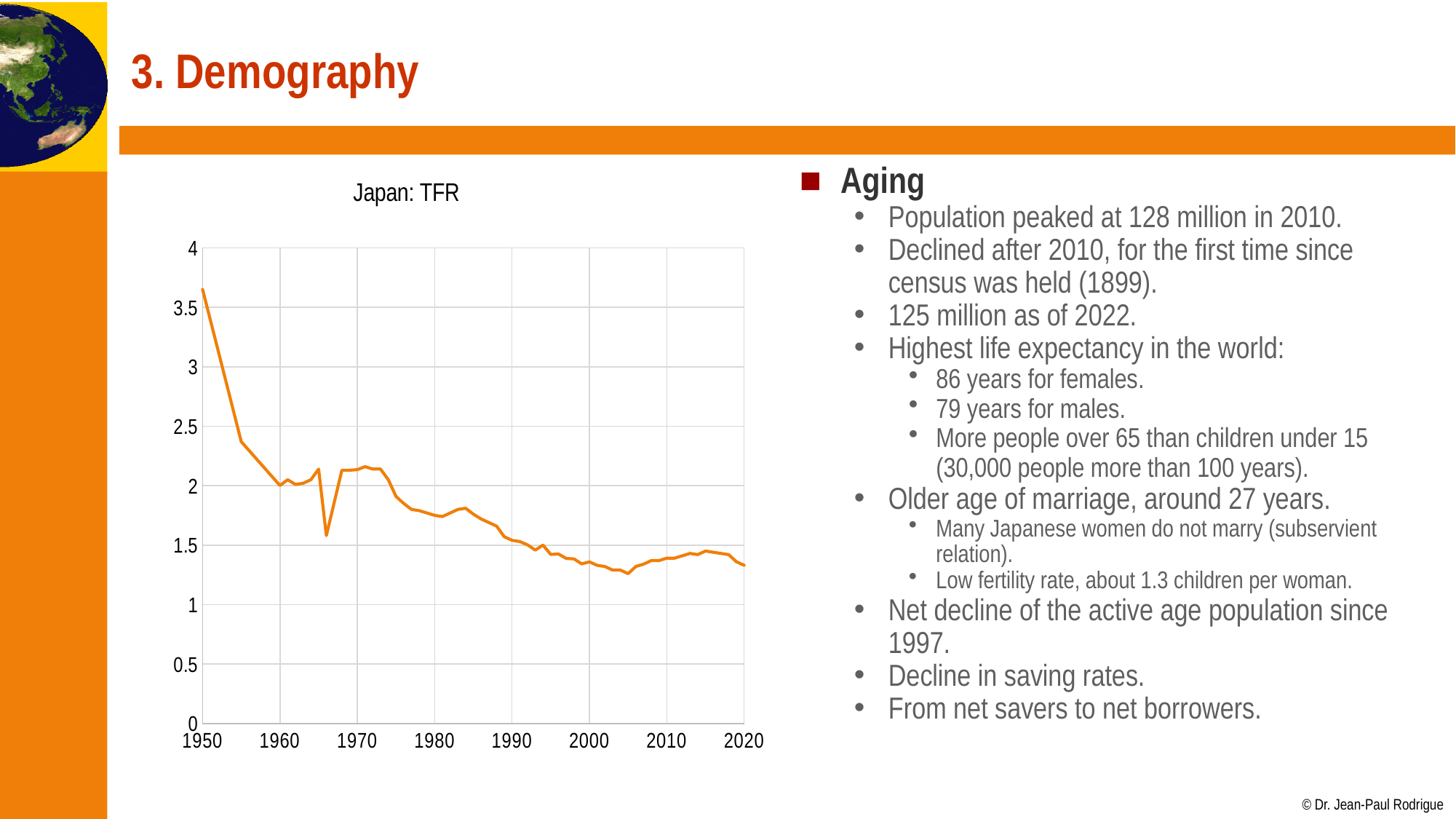
Is the TFR value for 2020 greater or less than 1.5? less What is the title of the chart? Japan: TFR Is the TFR value for 1980 greater or less than 2? less Overall, does the TFR rise or fall from 1950 to 2020? fall Which year has the larger TFR, 1950 or 2020? 1950 In which year shown on the x axis is the TFR highest? 1950 Is the TFR value for 1950 greater or less than 3.5? greater What kind of chart is shown on the slide? line chart What colour is the line plotted in the chart? orange How many year labels are shown on the x axis? 8 Which year has the larger TFR, 1970 or 1980? 1970